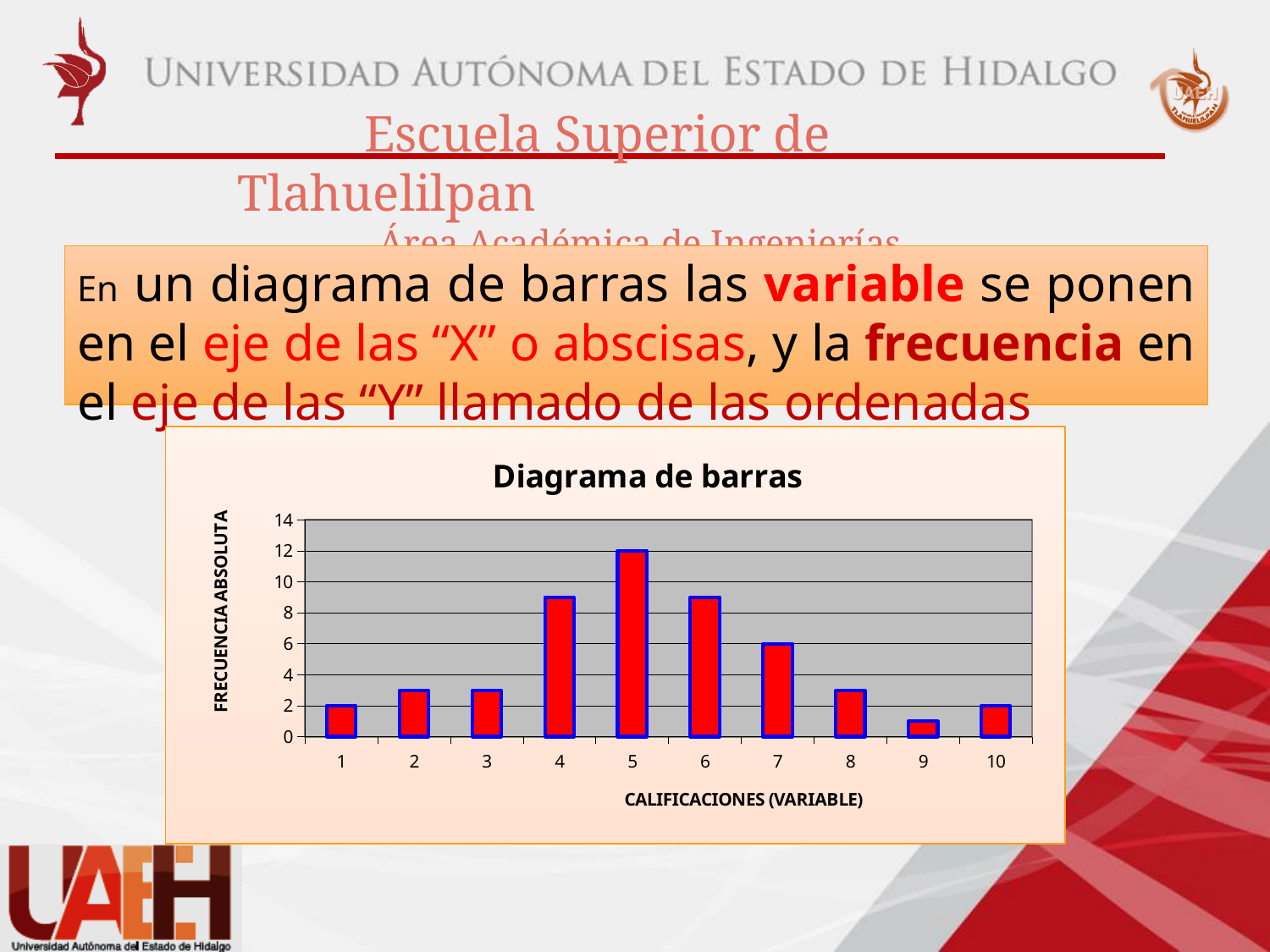
What is the label of the vertical axis of the chart? FRECUENCIA ABSOLUTA What is the title of the chart? Diagrama de barras What is the frecuencia absoluta for calificación 5? 12 What is the frecuencia absoluta for calificación 1? 2 Which has a larger frecuencia absoluta, calificación 6 or calificación 8? 6 Which calificación has the highest frecuencia absoluta? 5 Is the frecuencia absoluta for calificación 4 greater or less than 8? greater What kind of chart is shown on the slide? bar chart How many categories are shown on the x axis of the chart? 10 Which calificación has the lowest frecuencia absoluta? 9 What is the difference between the frecuencia absoluta for calificación 5 and calificación 7? 6 What is the frecuencia absoluta for calificación 7? 6